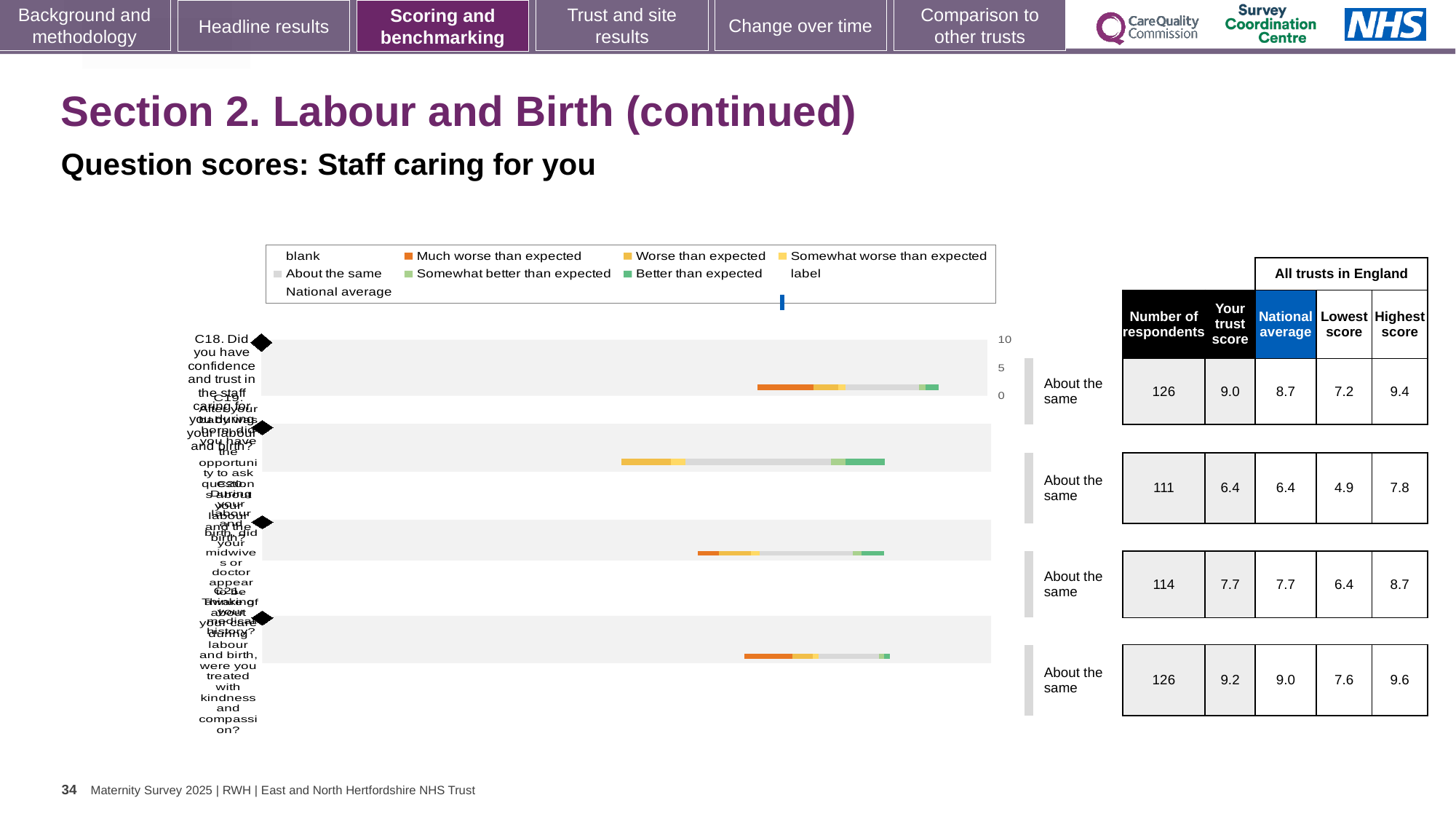
What is the lowest score among all trusts in England for the second row (C19)? 4.9 Which row has the highest trust score: the top row (C18) or the bottom row (C21, treated with kindness and compassion)? the bottom row (C21) What is the national average for C18 (confidence and trust in the staff caring for you)? 8.7 What is the difference between the trust score and the national average for C18? 0.3 What is the trust score for C18 (confidence and trust in the staff caring for you during labour and birth)? 9.0 What is the highest score among all trusts in England for the bottom row (C21, treated with kindness and compassion)? 9.6 What is the trust score for the third row (C20)? 7.7 How many questions (rows) are plotted in the chart? 4 What kind of chart is shown on the slide? bar chart Which row has the lowest trust score? the second row (C19) How many respondents answered C18 (confidence and trust in the staff caring for you)? 126 What benchmark category is shown for the top row (C18)? About the same